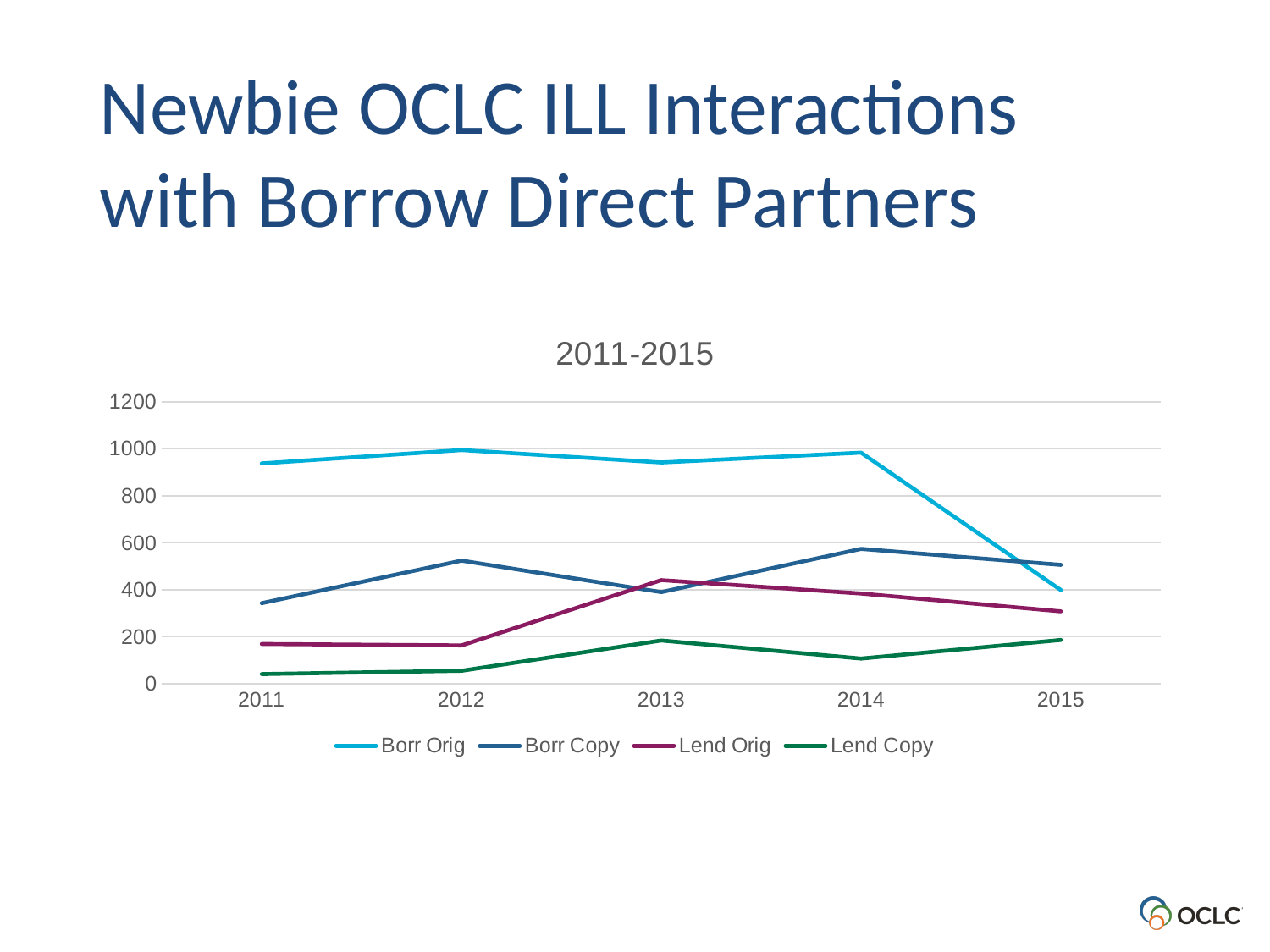
Is the value for Lend Copy in 2011 greater or less than 200? less How many series does the legend list? 4 Does the Borr Orig line rise or fall from 2014 to 2015? fall In which year does Lend Orig reach its highest value? 2013 Which series has the lowest value in 2014? Lend Copy Is the value for Borr Orig in 2015 greater or less than 600? less What kind of chart is shown on the slide? line chart Is the value for Borr Orig in 2012 greater or less than 800? greater How many years are plotted along the x axis? 5 Which series has the highest value in 2011? Borr Orig In 2015, which is larger: Borr Copy or Lend Orig? Borr Copy